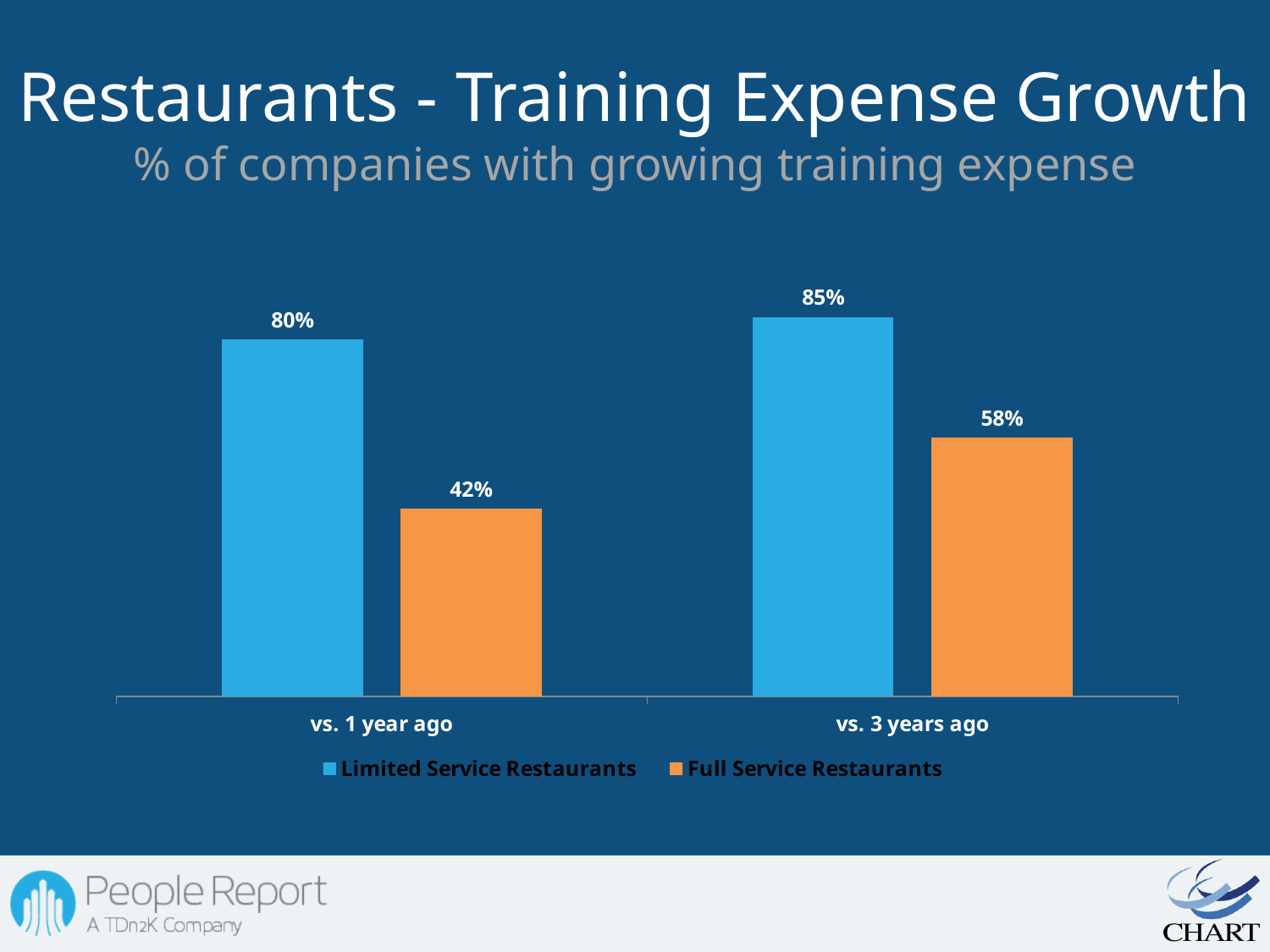
How many categories are shown on the x axis? 2 What is the difference between Limited Service Restaurants and Full Service Restaurants vs. 1 year ago? 38% What is the value for Full Service Restaurants vs. 1 year ago? 42% Which bar has the lowest value on the chart? Full Service Restaurants vs. 1 year ago Which is larger: Full Service Restaurants vs. 1 year ago or Full Service Restaurants vs. 3 years ago? Full Service Restaurants vs. 3 years ago What is the difference between the Limited Service Restaurants values vs. 3 years ago and vs. 1 year ago? 5% What is the value for Full Service Restaurants vs. 3 years ago? 58% Which series has the highest value in the vs. 3 years ago category? Limited Service Restaurants How many series does the legend list? 2 What colour are the Full Service Restaurants bars? Orange What kind of chart is shown on the slide? Bar chart What is the value for Limited Service Restaurants vs. 1 year ago? 80%